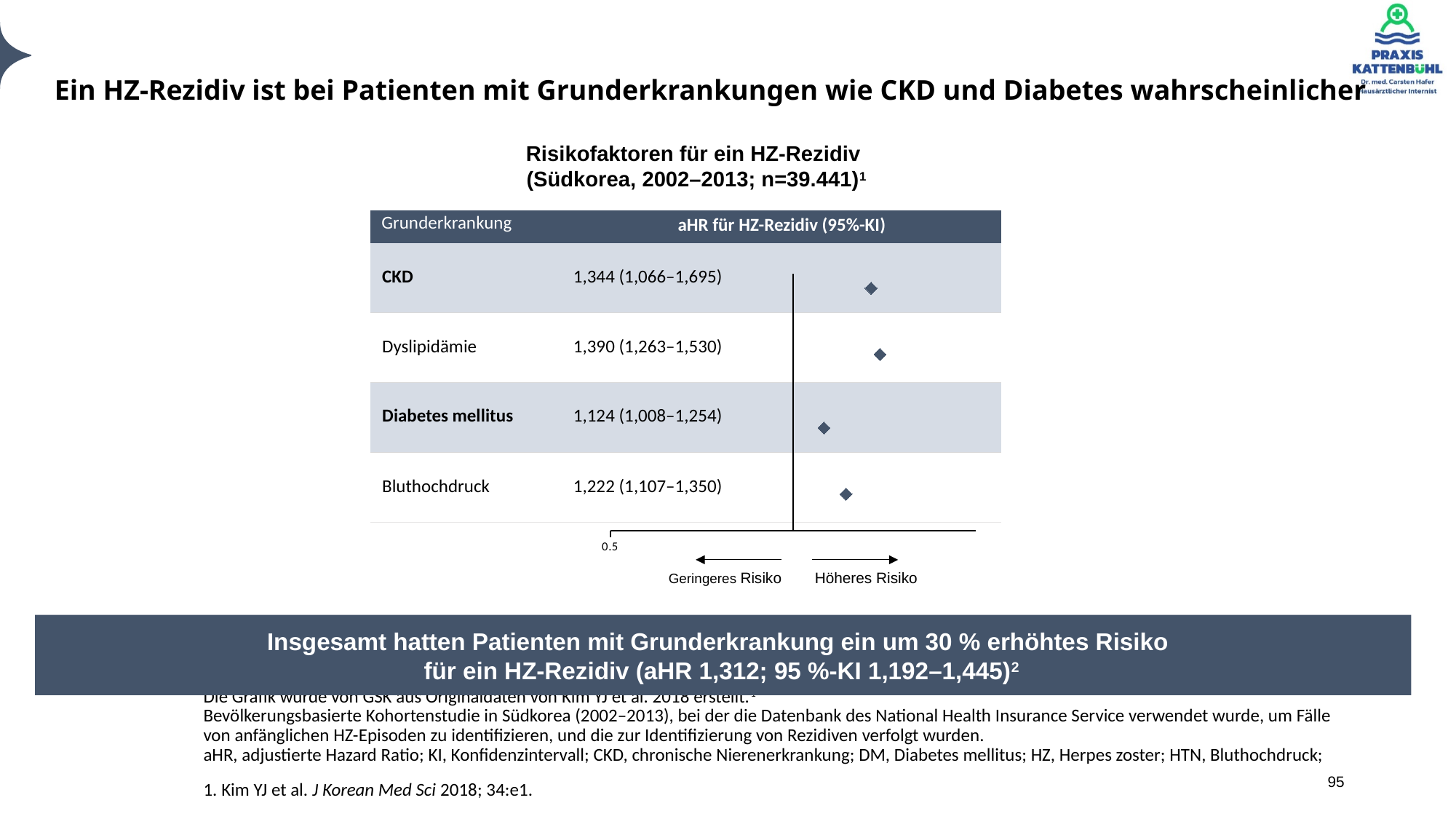
Which has a larger aHR for HZ-Rezidiv, Bluthochdruck or Diabetes mellitus? Bluthochdruck What is the title of the chart? Risikofaktoren für ein HZ-Rezidiv (Südkorea, 2002–2013; n=39.441) What kind of chart is shown on the slide? forest plot What is the aHR for HZ-Rezidiv for Diabetes mellitus? 1,124 What is the difference between the aHR for CKD and the aHR for Diabetes mellitus? 0,220 Which Grunderkrankung has the lowest aHR for HZ-Rezidiv? Diabetes mellitus How many Grunderkrankungen are shown in the chart? 4 What is the difference between the aHR for Dyslipidämie and the aHR for CKD? 0,046 What is the 95%-KI for Dyslipidämie? 1,263–1,530 What is the aHR for HZ-Rezidiv for CKD? 1,344 Which Grunderkrankung has the highest aHR for HZ-Rezidiv? Dyslipidämie What is the aHR (95%-KI) for Bluthochdruck? 1,222 (1,107–1,350)